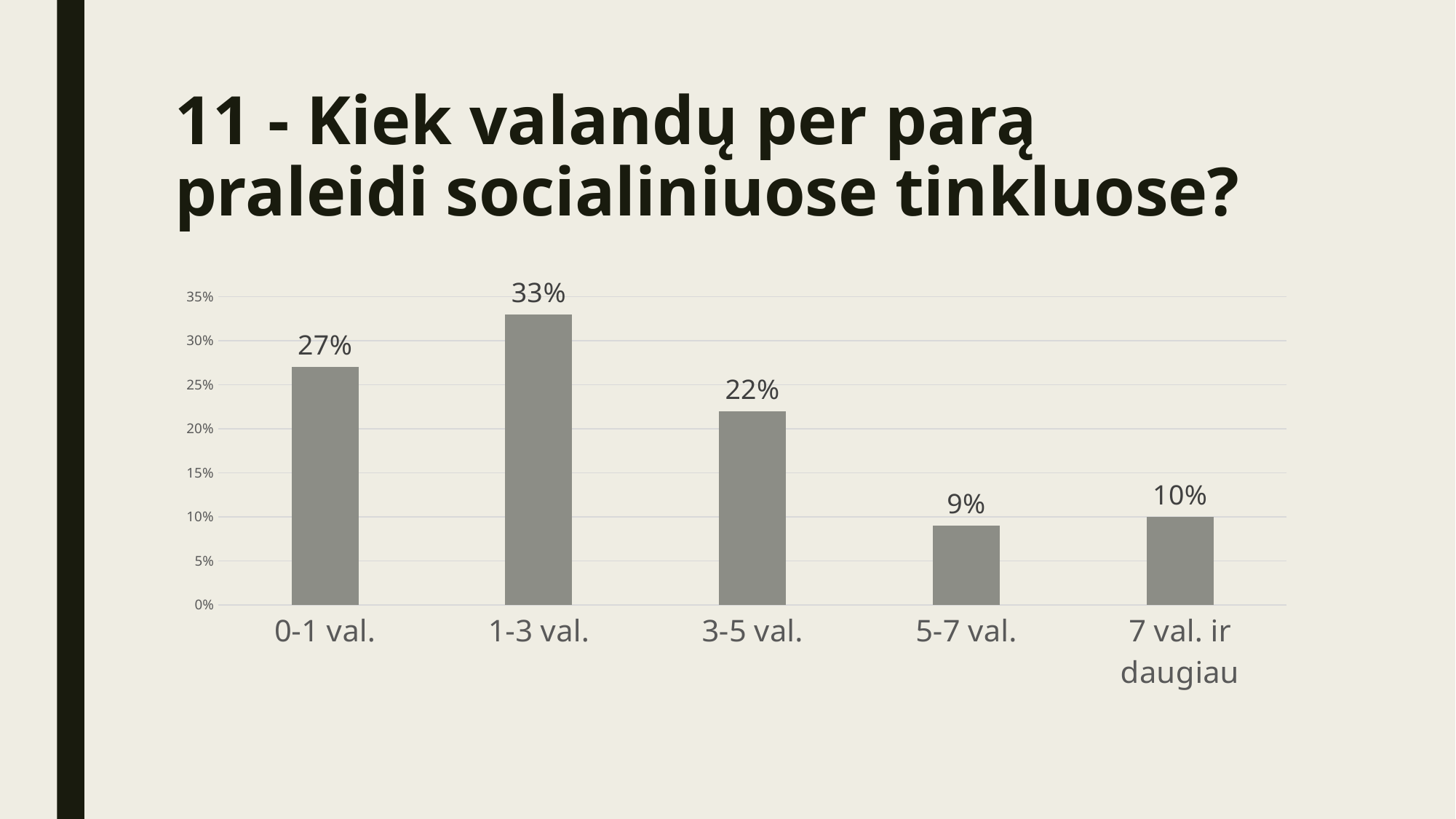
What is the difference between the values for "1-3 val." and "3-5 val."? 11% Which is larger, the value for "0-1 val." or the value for "3-5 val."? 0-1 val. How many categories are shown on the x axis? 5 Which category has the highest value? 1-3 val. What is the value for the "1-3 val." category? 33% What kind of chart is shown on the slide? Bar chart What is the value for the "0-1 val." category? 27% What is the difference between the values for "0-1 val." and "5-7 val."? 18% What is the title of the slide above the chart? 11 - Kiek valandų per parą praleidi socialiniuose tinkluose? What is the value for the "7 val. ir daugiau" category? 10% Which category has the lowest value? 5-7 val. Is the value for "3-5 val." greater or less than 25%? less